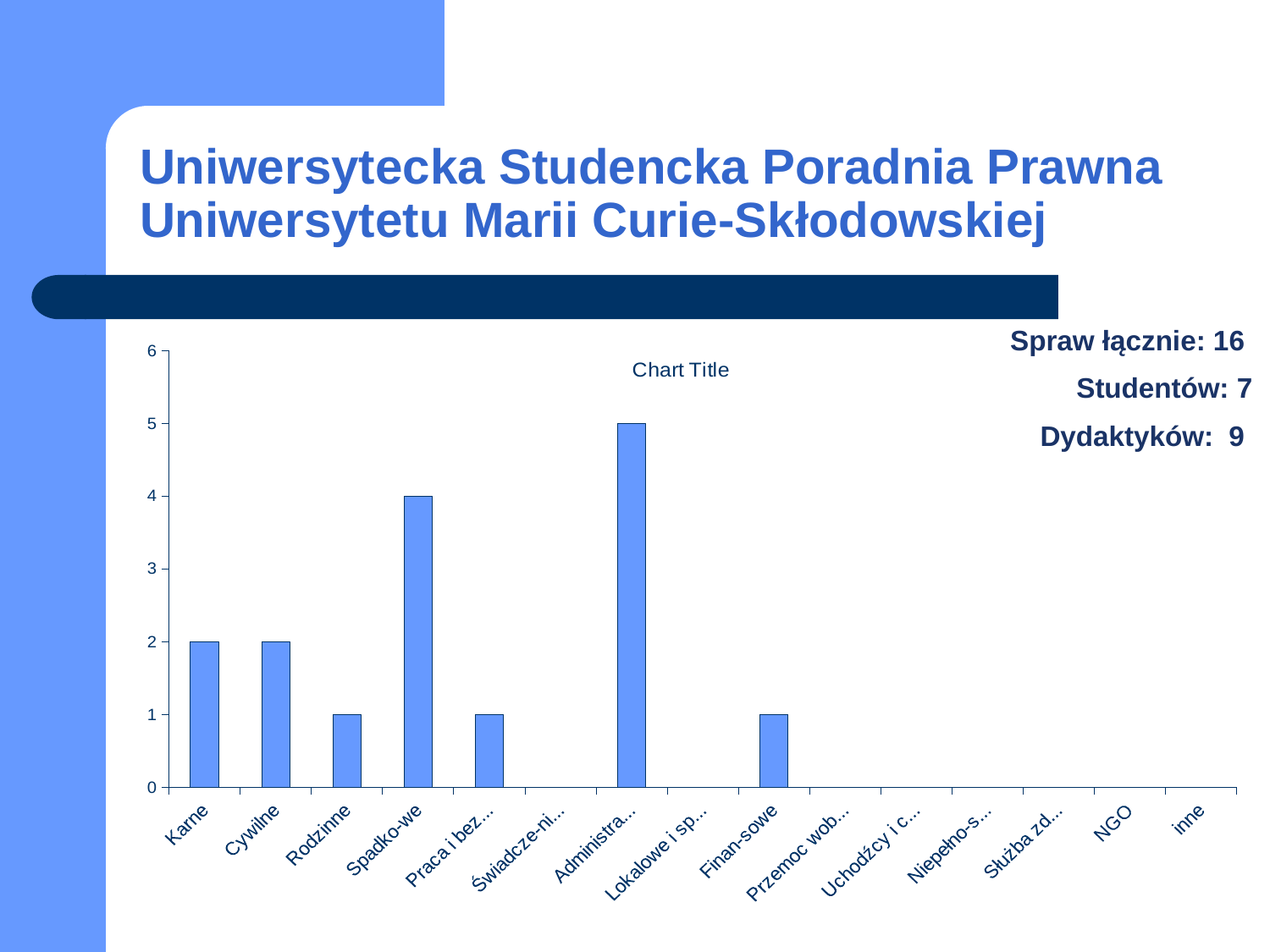
What is the difference between the values for Spadko-we and Karne? 2 What is the value for NGO? 0 What is the value for Spadko-we? 4 What is the title of the chart? Chart Title Which category has the highest bar? Administra... Which is larger, the value for Spadko-we or the value for Cywilne? Spadko-we What type of chart is shown on the slide? bar chart What is the value for Finan-sowe? 1 What is the value for Karne? 2 How many categories are shown on the x axis? 15 Is the value for Spadko-we greater or less than 3? greater What is the value for Rodzinne? 1